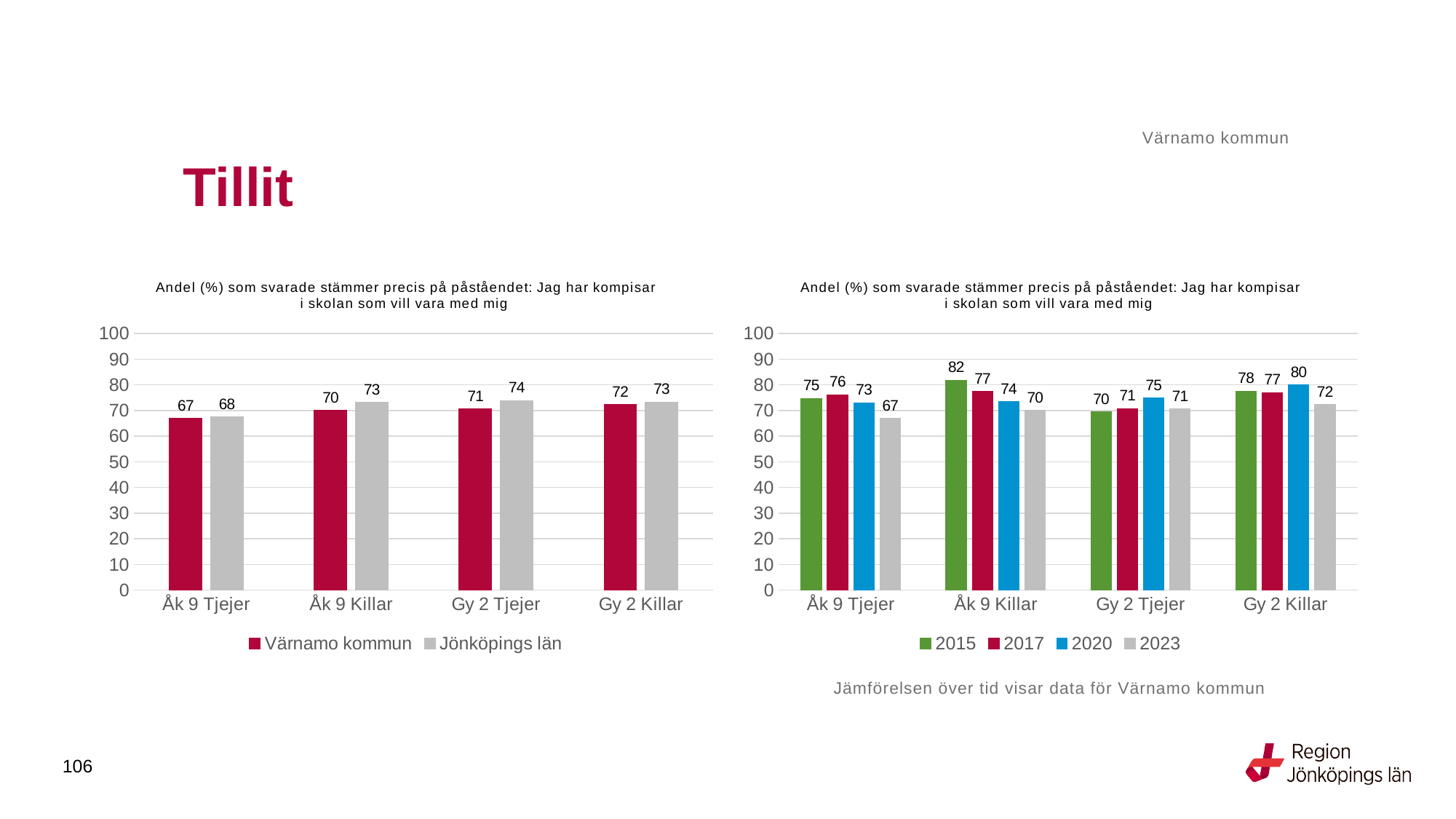
In the right chart, which category has the highest value for 2020? Gy 2 Killar In the left chart, how many series does the legend list? 2 In the right chart, how many categories are shown on the x axis? 4 In the right chart, which is larger for Åk 9 Tjejer: the 2017 value or the 2023 value? 2017 In the left chart, what is the difference between Jönköpings län and Värnamo kommun for Åk 9 Killar? 3 In the left chart, what is the value for Värnamo kommun for Åk 9 Tjejer? 67 In the right chart, what is the value for 2015 for Åk 9 Killar? 82 In the left chart, what is the value for Jönköpings län for Gy 2 Tjejer? 74 In the right chart, what is the difference between the 2015 and 2023 values for Åk 9 Killar? 12 In the left chart, which category has the lowest value for Värnamo kommun? Åk 9 Tjejer What kind of chart is the left chart? Bar chart In the right chart, what is the value for 2023 for Gy 2 Killar? 72